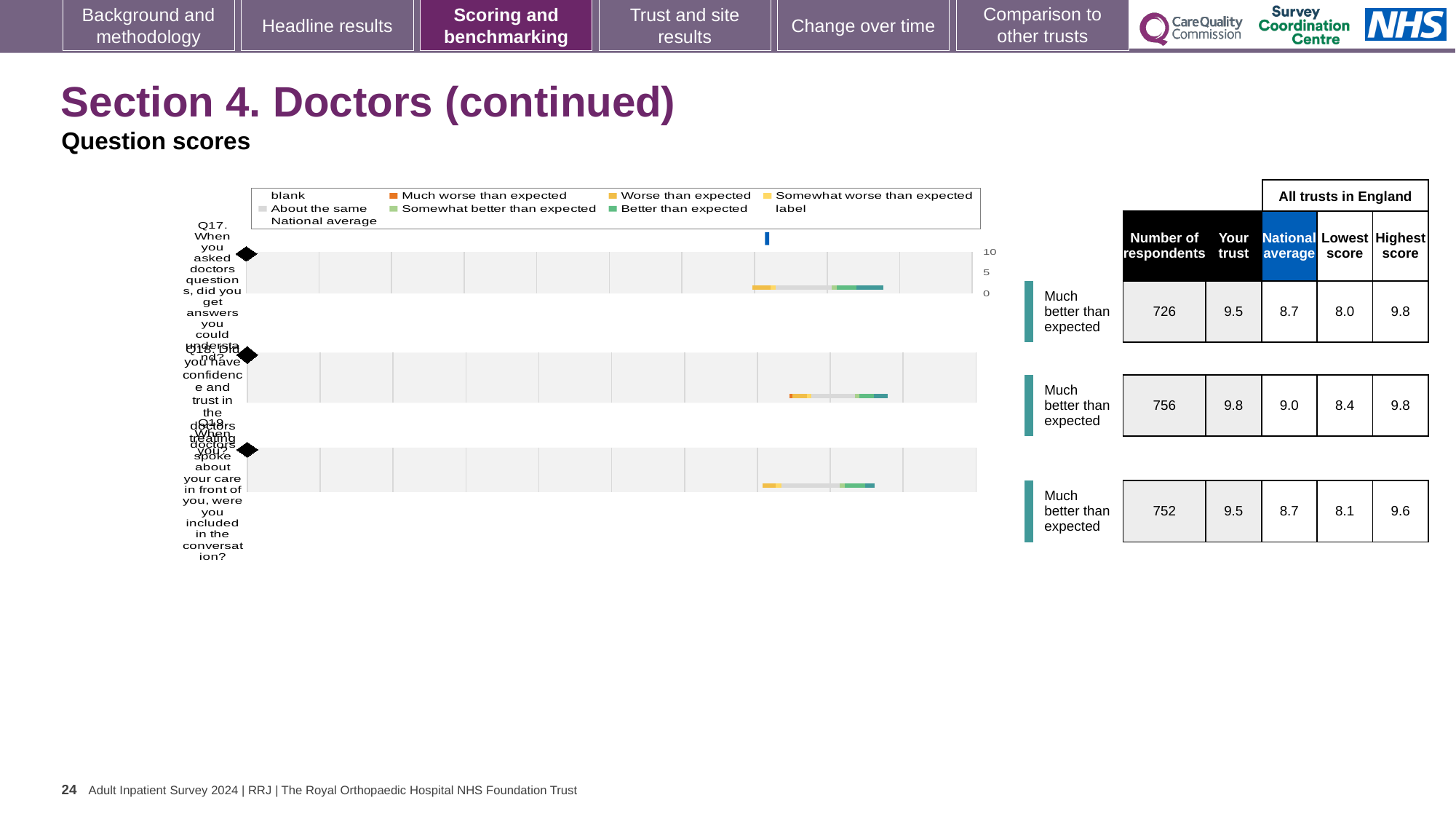
What is the 'Your trust' score for Q18 (Did you have confidence and trust in the doctors treating you?)? 9.8 What is the lowest score among all trusts in England for Q18? 8.4 Which question has the lowest 'Lowest score' among all trusts in England? Q17 How many respondents answered Q19 (When doctors spoke about your care in front of you, were you included in the conversation?)? 752 What benchmark category is shown next to Q17 in the chart? Much better than expected What type of chart is used to show the question scores on this slide? bar chart Is the 'Your trust' score for Q19 greater or less than 5 on the chart's axis? greater What is the national average score for Q17 (When you asked doctors questions, did you get answers you could understand?)? 8.7 For Q17, which is larger: the 'Your trust' score or the national average? Your trust What is the difference between the 'Your trust' score and the national average for Q18? 0.8 Which question has the highest 'Your trust' score? Q18 How many questions are plotted in the chart? 3